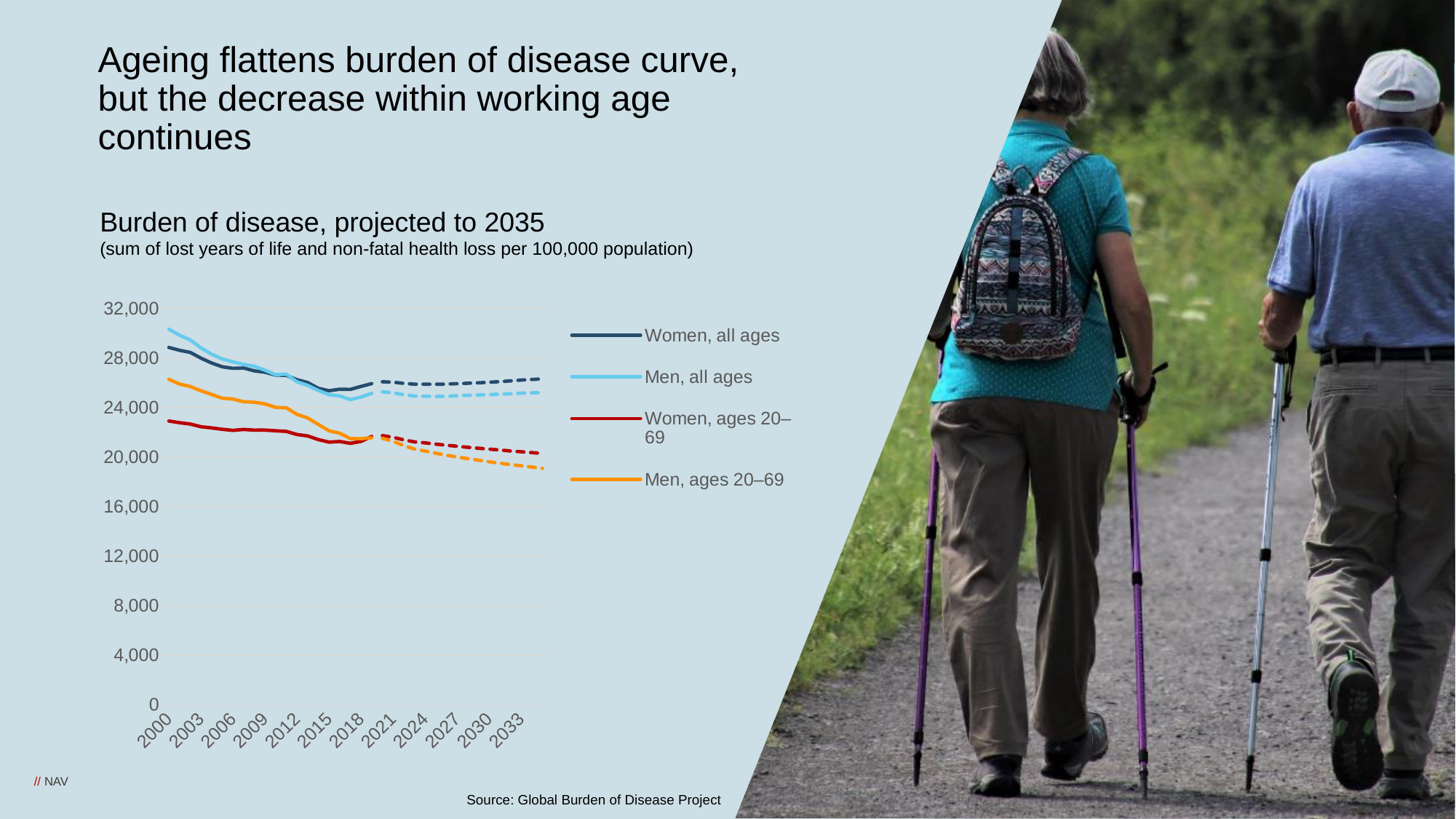
What is the title of the chart? Burden of disease, projected to 2035 Does the Men, ages 20–69 series rise or fall from 2000 to 2035? Fall At the end of the projection (2035), which is higher: Women, ages 20–69 or Men, ages 20–69? Women, ages 20–69 Is the value for Women, ages 20–69 in 2000 greater or less than 24,000? less How many series does the legend list? 4 Which series has the highest value in 2000? Men, all ages Which series is listed last in the legend? Men, ages 20–69 What kind of chart is shown on the slide? Line chart Is the value for Women, all ages at the end of the projection (2035) greater or less than 24,000? greater Is the value for Men, all ages in 2000 greater or less than 28,000? greater Which series has the lowest value at the end of the projection (2035)? Men, ages 20–69